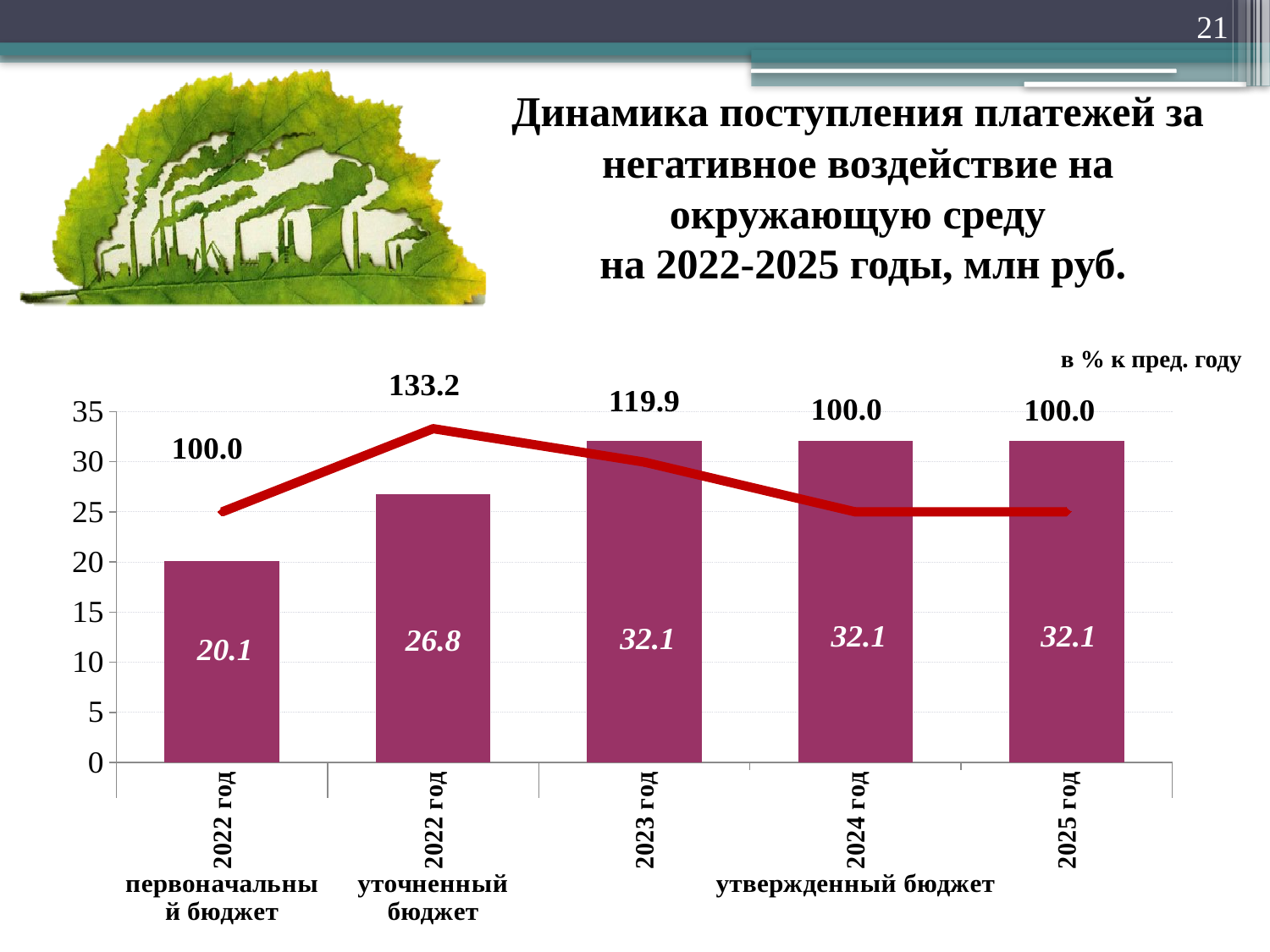
What is the value of the bar for 2022 год (первоначальный бюджет)? 20.1 What is the percentage to the previous year (в % к пред. году) shown on the line for 2022 год (уточненный бюджет)? 133.2 How many bars are plotted on the chart? 5 Which is larger: the bar value for 2023 год or for 2022 год (уточненный бюджет)? 2023 год What is the difference between the bar values for 2022 год (уточненный бюджет) and 2022 год (первоначальный бюджет)? 6.7 What is the percentage to the previous year (в % к пред. году) shown on the line for 2023 год? 119.9 Do the bar values rise or fall from 2022 год (первоначальный бюджет) to 2023 год? rise What kind of chart is shown on the slide? Combined bar and line chart Which category has the lowest bar value? 2022 год (первоначальный бюджет) Which category has the highest value on the line (в % к пред. году)? 2022 год (уточненный бюджет) What is the value of the bar for 2023 год? 32.1 What is the value of the bar for 2022 год (уточненный бюджет)? 26.8